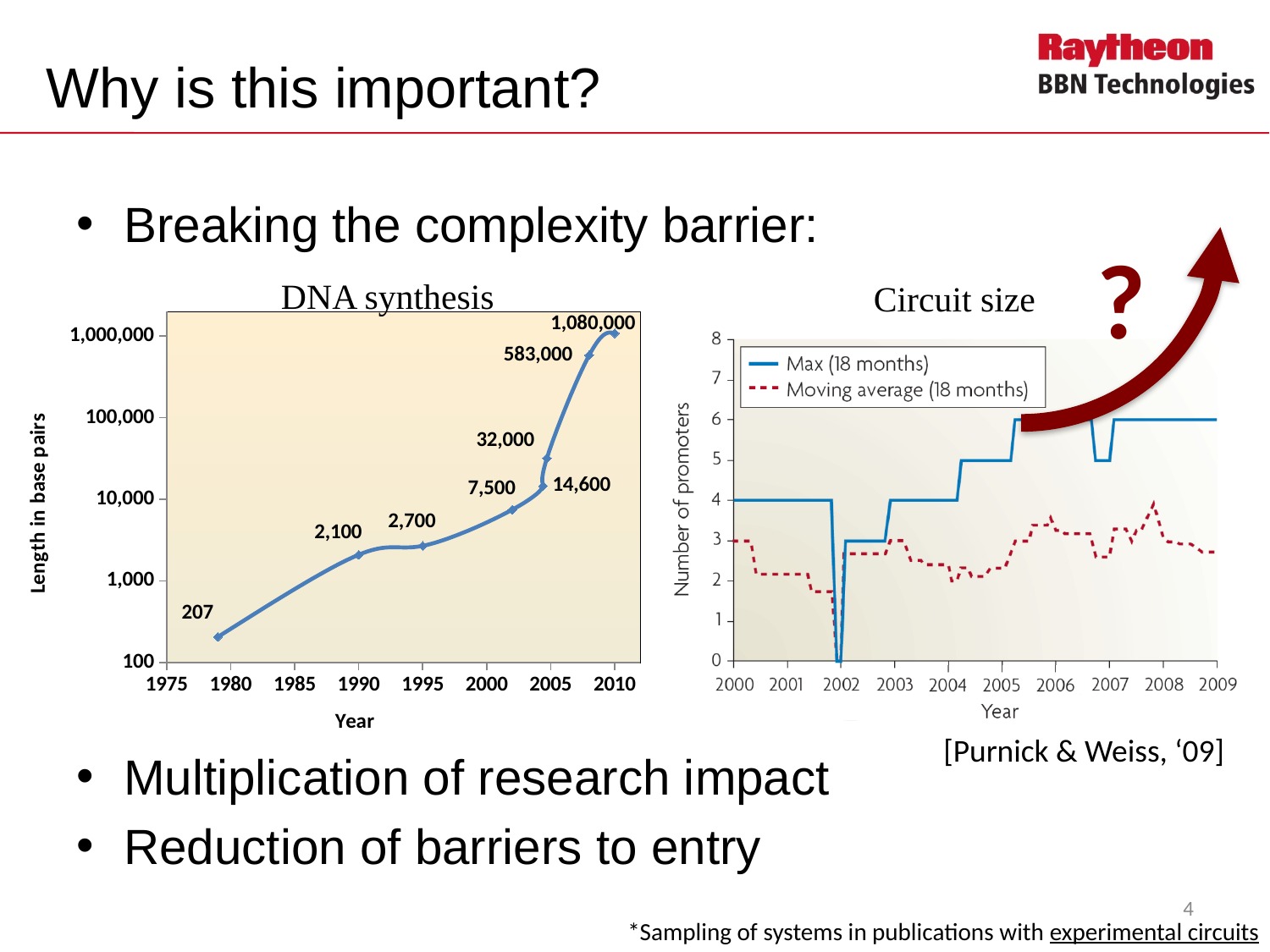
What kind of chart is the Circuit size chart? line chart On the DNA synthesis chart, which is larger: the labelled value 14,600 or the labelled value 7,500? 14,600 What is the y-axis label of the DNA synthesis chart? Length in base pairs On the DNA synthesis chart, what is the difference between the labelled values 1,080,000 and 583,000? 497,000 On the Circuit size chart, what is the value of the Max (18 months) line in 2009? 6 On the DNA synthesis chart, how many data points carry value labels? 8 On the DNA synthesis chart, what is the lowest labelled length in base pairs? 207 On the DNA synthesis chart, what is the highest labelled length in base pairs? 1,080,000 On the Circuit size chart, what is the lowest value reached by the Max (18 months) line? 0 How many series does the legend of the Circuit size chart list? 2 On the Circuit size chart, is the Max (18 months) value in 2000 greater or less than 3? greater On the DNA synthesis chart, do the values rise or fall as the year increases? rise